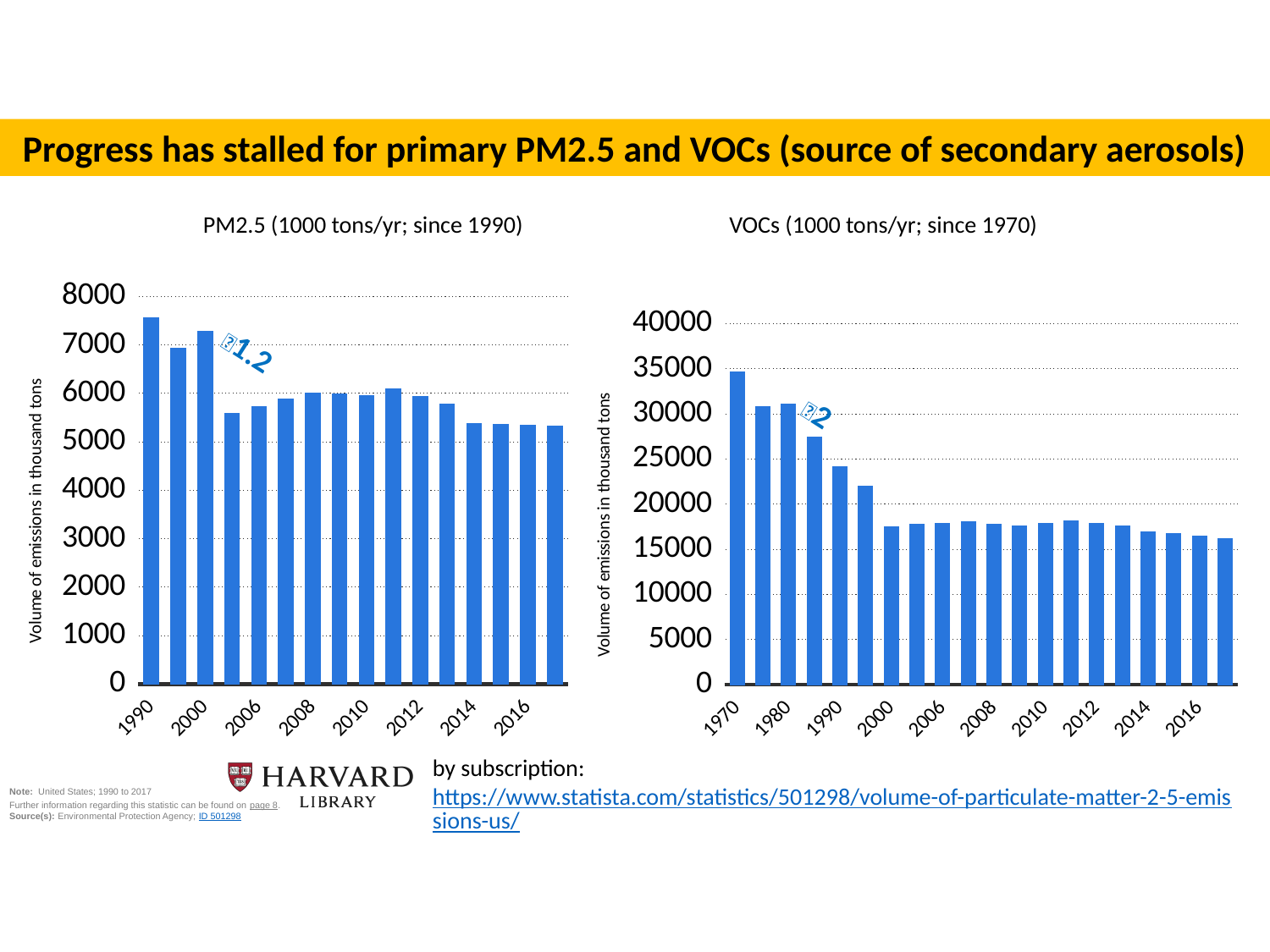
In the PM2.5 chart, which year has the highest emissions? 1990 In the VOCs chart, is the value for 1980 greater or less than 30000? greater In the VOCs chart, which is larger, the value for 1990 or the value for 2010? 1990 In the PM2.5 chart, is the value for 1990 greater or less than 7000? greater In the VOCs chart, which year has the highest emissions? 1970 What kind of chart is the PM2.5 chart on the left? bar chart In the PM2.5 chart, do the values generally rise or fall from 1990 to 2016? fall In the PM2.5 chart, is the value for 2016 greater or less than 6000? less What kind of chart is the VOCs chart on the right? bar chart What is the y-axis label of the VOCs chart? Volume of emissions in thousand tons